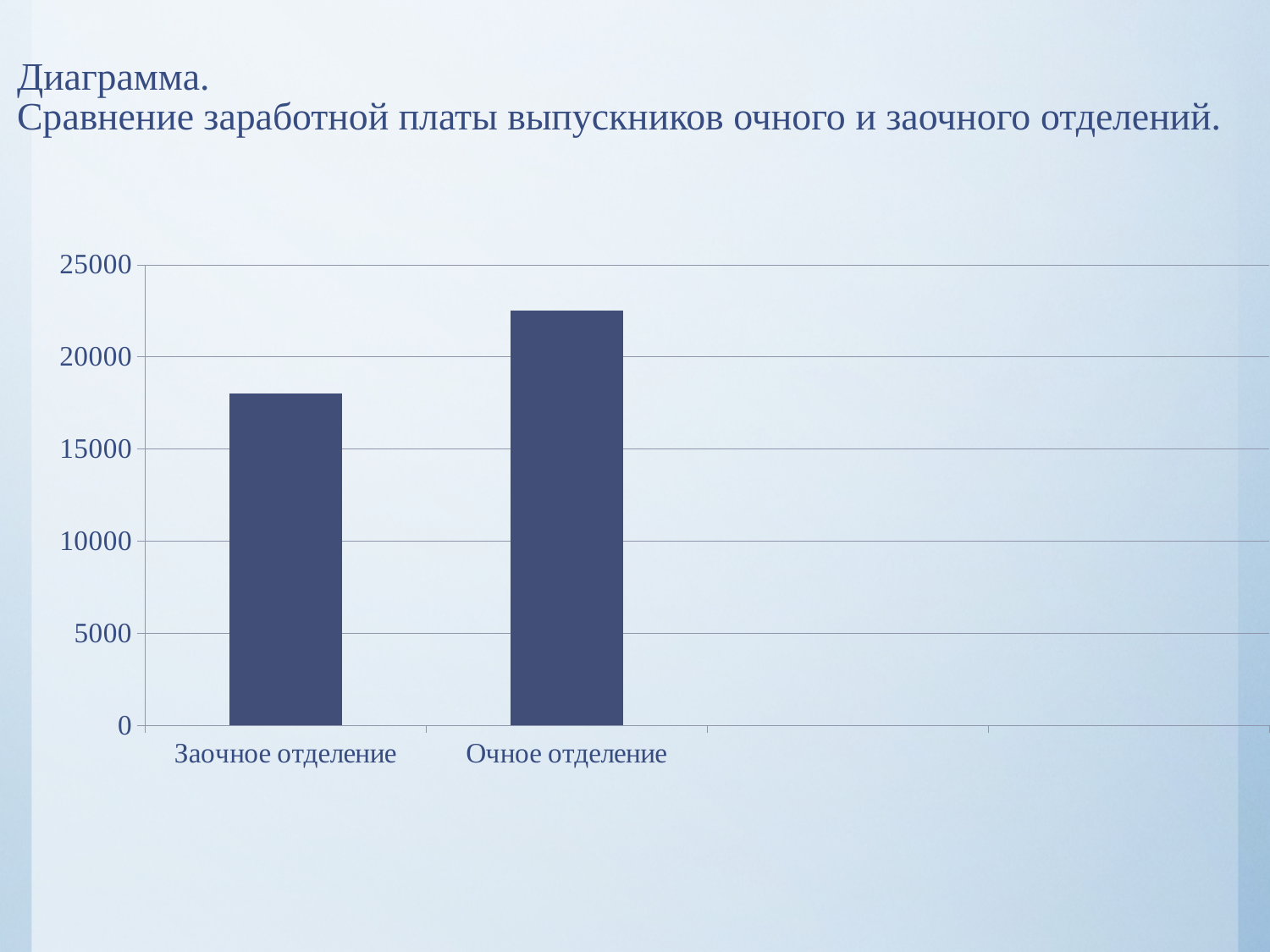
Which category has the highest bar? Очное отделение Which category has the lowest bar? Заочное отделение Is the value for Заочное отделение greater or less than 20000? less How many categories are plotted on the chart? 2 Is the value for Очное отделение greater or less than 20000? greater Is the value for Заочное отделение greater or less than 15000? greater Which is larger, the value for Заочное отделение or the value for Очное отделение? Очное отделение What is the label of the first category on the horizontal axis? Заочное отделение What kind of chart is shown on the slide? bar chart What is the highest value shown on the vertical axis? 25000